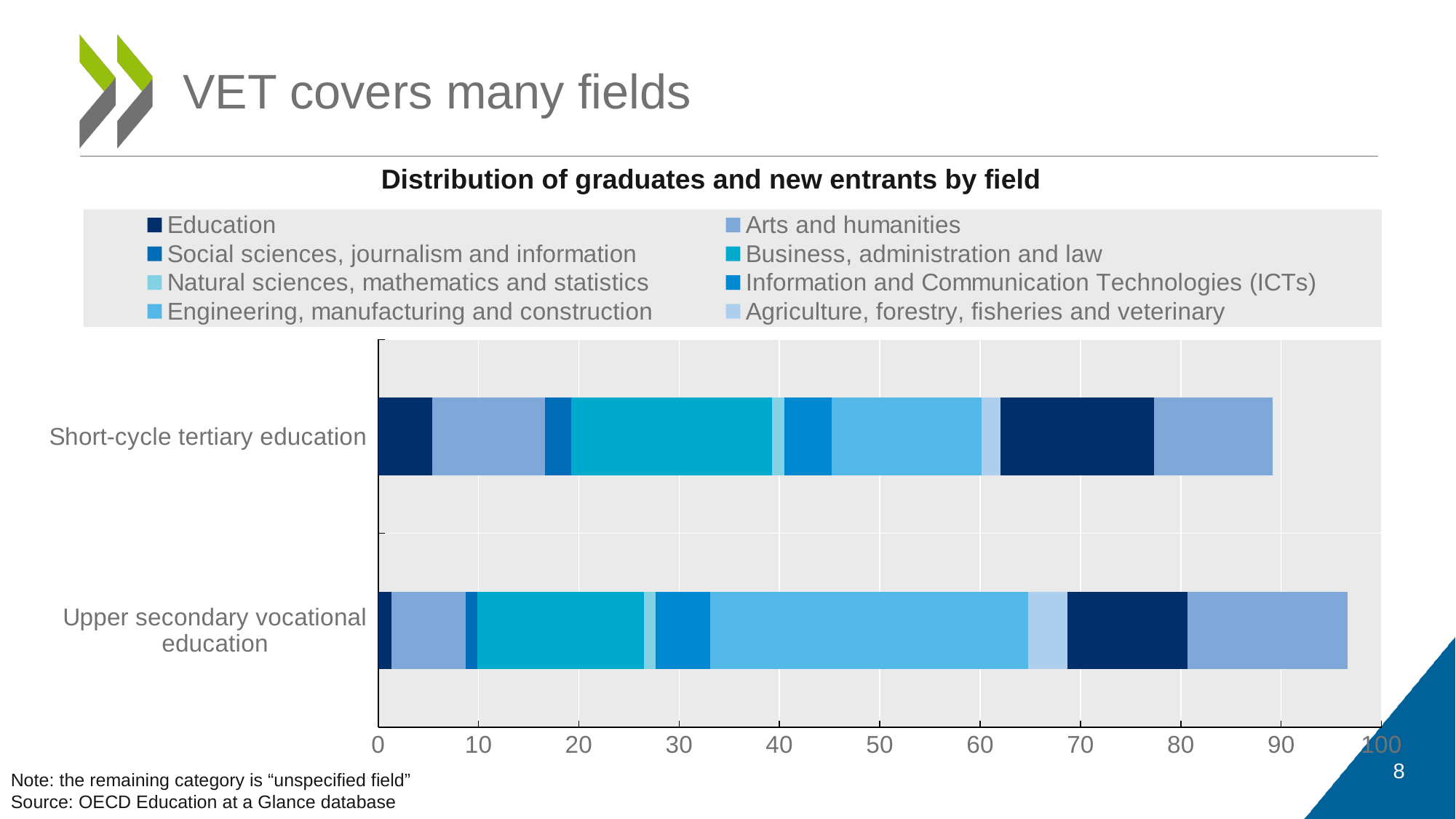
How many categories (education levels) are plotted on the y axis? 2 Is the total length of the Upper secondary vocational education bar greater or less than 90? greater Which category has the larger Engineering, manufacturing and construction segment? Upper secondary vocational education What kind of chart is shown on the slide? Stacked bar chart Is the total length of the Short-cycle tertiary education bar greater or less than 90? less Which category has the longer total stacked bar, Short-cycle tertiary education or Upper secondary vocational education? Upper secondary vocational education Is the Education segment for Upper secondary vocational education greater or less than 10? less Which category has the larger Arts and humanities segment? Short-cycle tertiary education According to the note below the chart, what is the remaining category? "unspecified field" How many series does the legend list? 8 What is the title of the chart? Distribution of graduates and new entrants by field